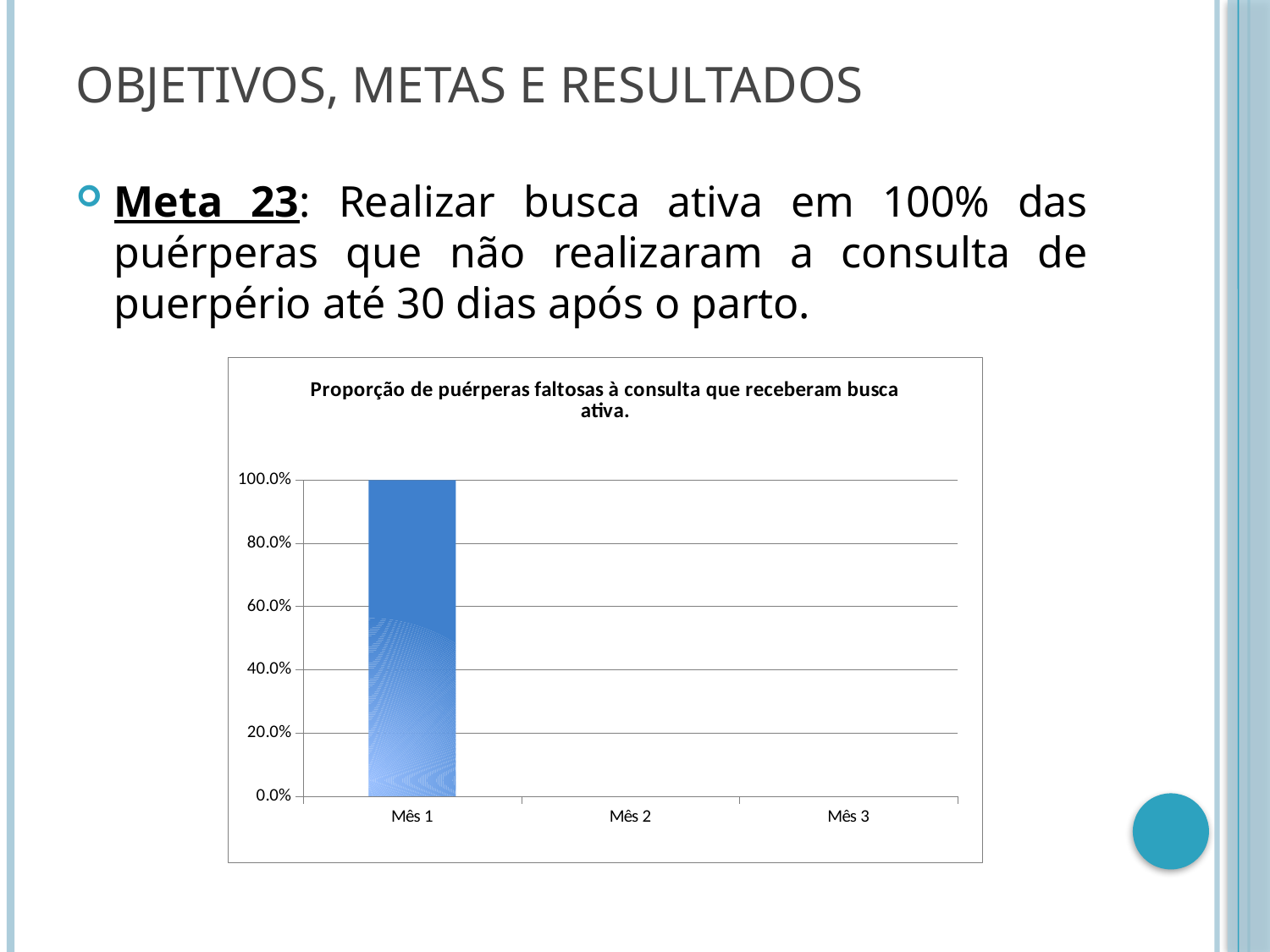
What is the highest tick value shown on the y axis of the chart? 100.0% Is the value for Mês 1 greater or less than 80.0%? greater How many categories are shown on the x axis of the chart? 3 Which is larger, the value for Mês 1 or the value for Mês 2? Mês 1 What kind of chart is shown on the slide? bar chart What is the label of the first category on the x axis? Mês 1 Which category has the highest value in the chart? Mês 1 What is the value for Mês 1 in the chart? 100.0% What is the title of the chart? Proporção de puérperas faltosas à consulta que receberam busca ativa. What is the label of the last category on the x axis? Mês 3